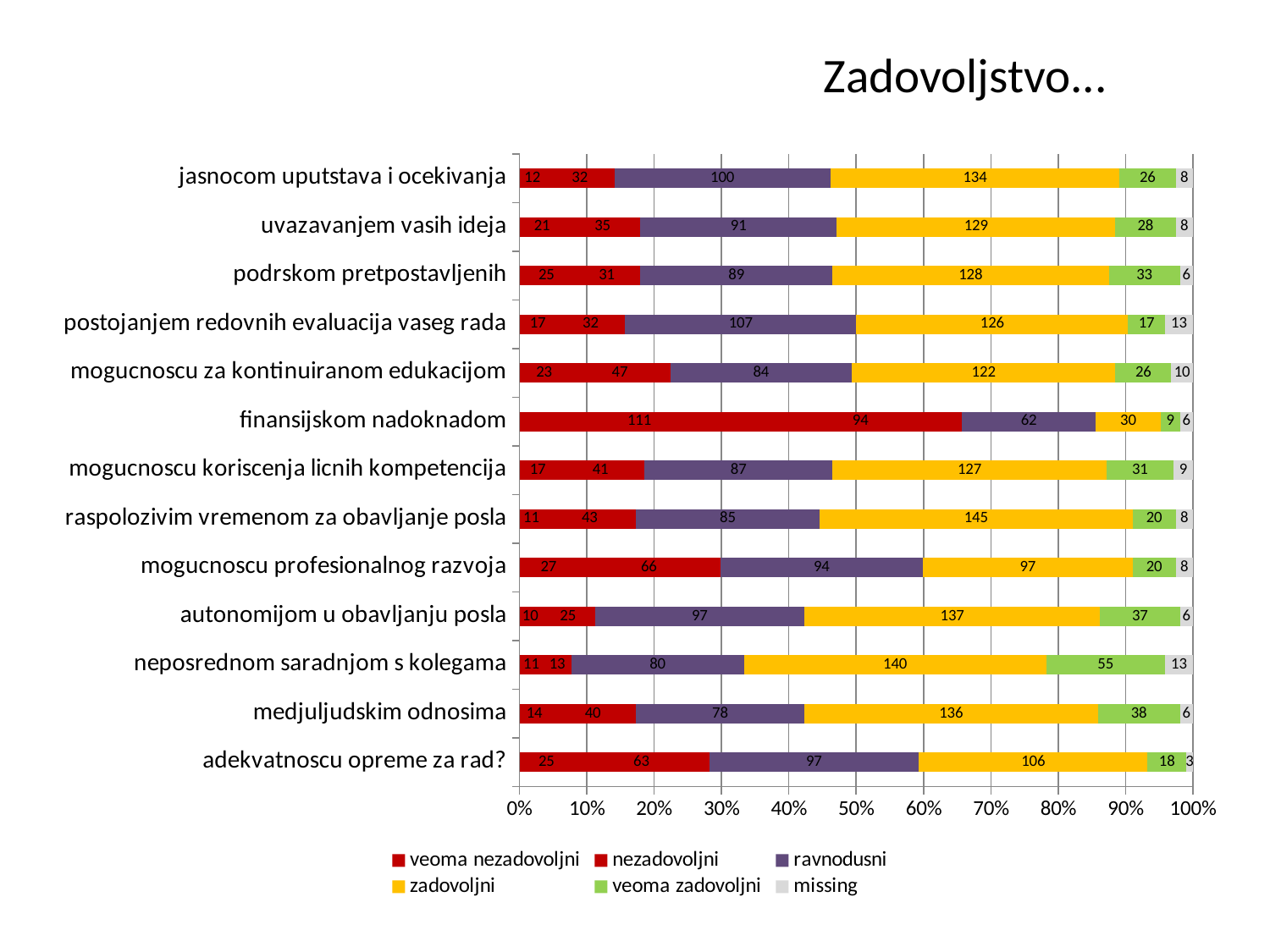
Which category has the lowest "zadovoljni" value? finansijskom nadoknadom What kind of chart is shown on the slide? stacked bar chart Which category has the highest "veoma zadovoljni" value? neposrednom saradnjom s kolegama Which has a larger "zadovoljni" value: "neposrednom saradnjom s kolegama" or "mogucnoscu profesionalnog razvoja"? neposrednom saradnjom s kolegama How many series does the legend list? 6 What is the total of all segments in the bar for "finansijskom nadoknadom"? 312 What is the title of the chart? Zadovoljstvo… How many respondents answered "zadovoljni" for "raspolozivim vremenom za obavljanje posla"? 145 What is the difference between the "zadovoljni" values for "raspolozivim vremenom za obavljanje posla" and "finansijskom nadoknadom"? 115 What is the "veoma nezadovoljni" value for "finansijskom nadoknadom"? 111 How many categories are shown on the chart? 13 What is the "ravnodusni" value for "postojanjem redovnih evaluacija vaseg rada"? 107